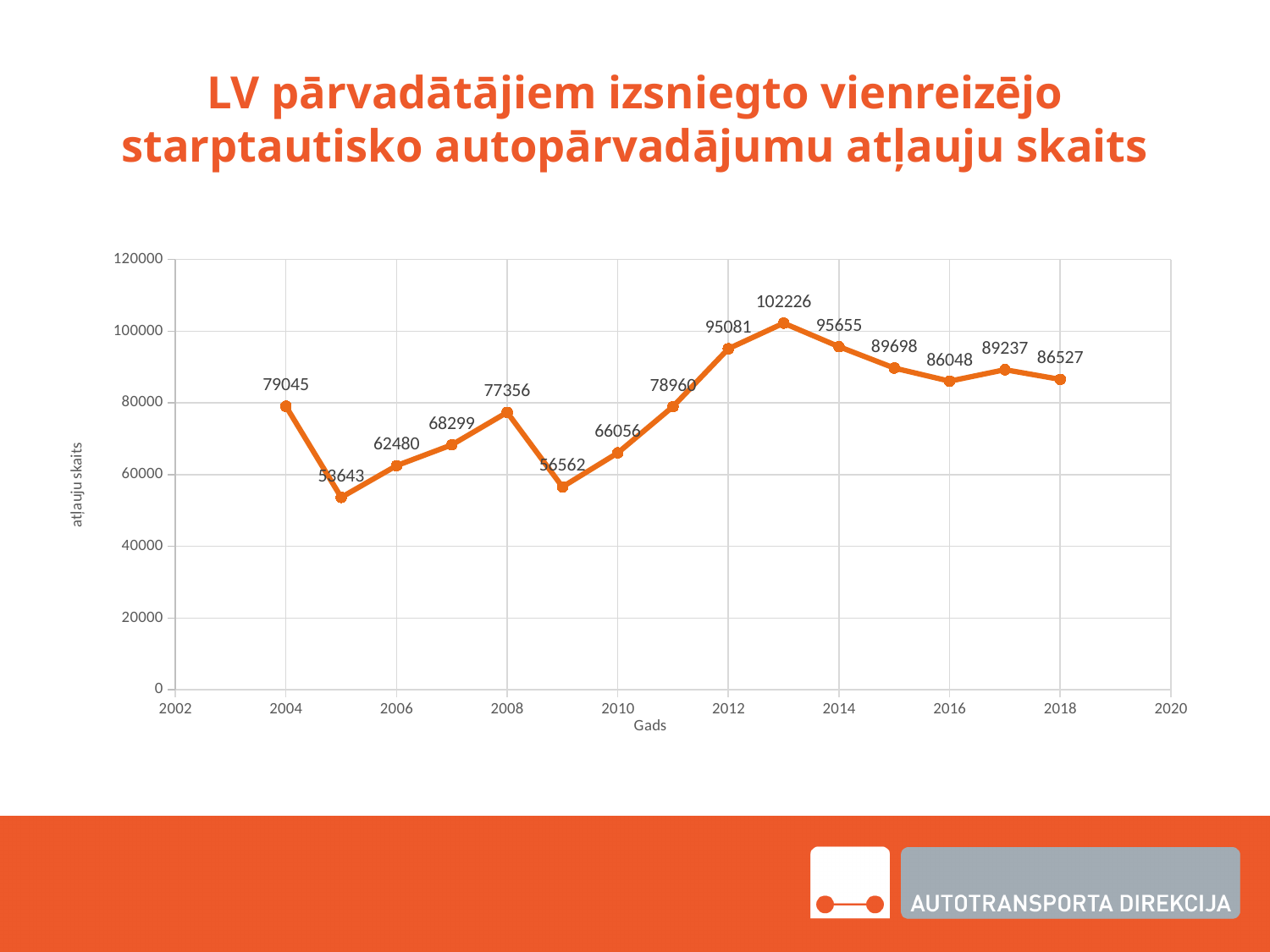
What is the value for 2005? 53643 Which year has the lowest value? 2005 Which is larger, the value for 2008 or the value for 2011? 2011 What is the difference between the values for 2004 and 2005? 25402 What is the difference between the values for 2013 and 2012? 7145 What is the value for 2010? 66056 How many data points are plotted on the chart? 15 Which year has the highest value? 2013 Is the value for 2009 greater or less than 60000? less What is the value for 2013? 102226 What type of chart is shown on the slide? Line chart What is the label of the x axis? Gads